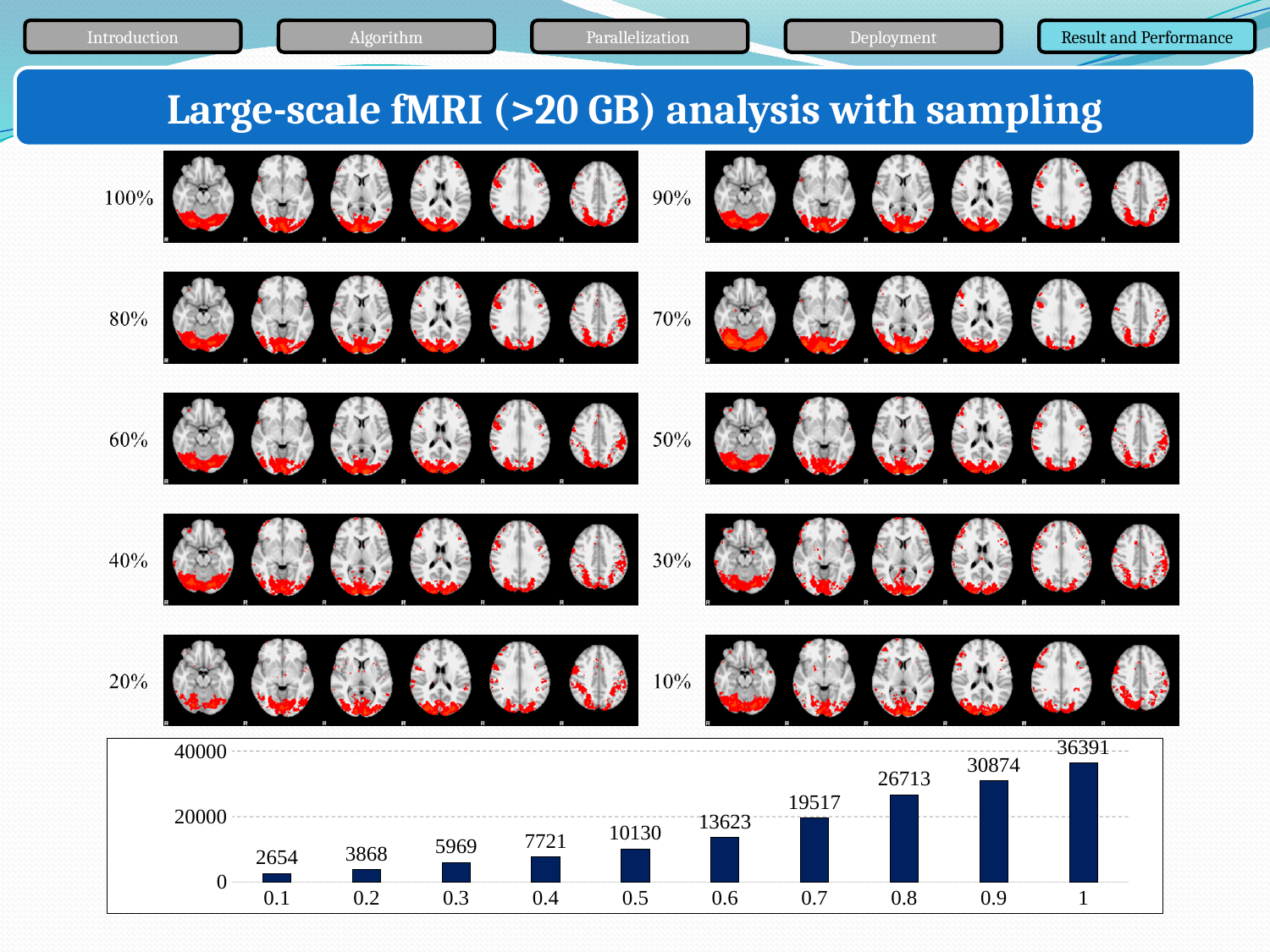
Which is larger in the bar chart, the value for 0.4 or the value for 0.3? 0.4 Is the value for 0.9 in the bar chart greater or less than 20000? greater What is the difference between the values for 1 and 0.9 in the bar chart? 5517 What is the value for 0.8 in the bar chart? 26713 What is the value for 0.1 in the bar chart? 2654 What is the difference between the values for 0.7 and 0.6 in the bar chart? 5894 What kind of chart is shown at the bottom of the slide? bar chart How many bars are in the bar chart? 10 Which category has the highest value in the bar chart? 1 Do the values in the bar chart rise or fall from 0.1 to 1? rise Which category has the lowest value in the bar chart? 0.1 What is the value for 0.5 in the bar chart? 10130